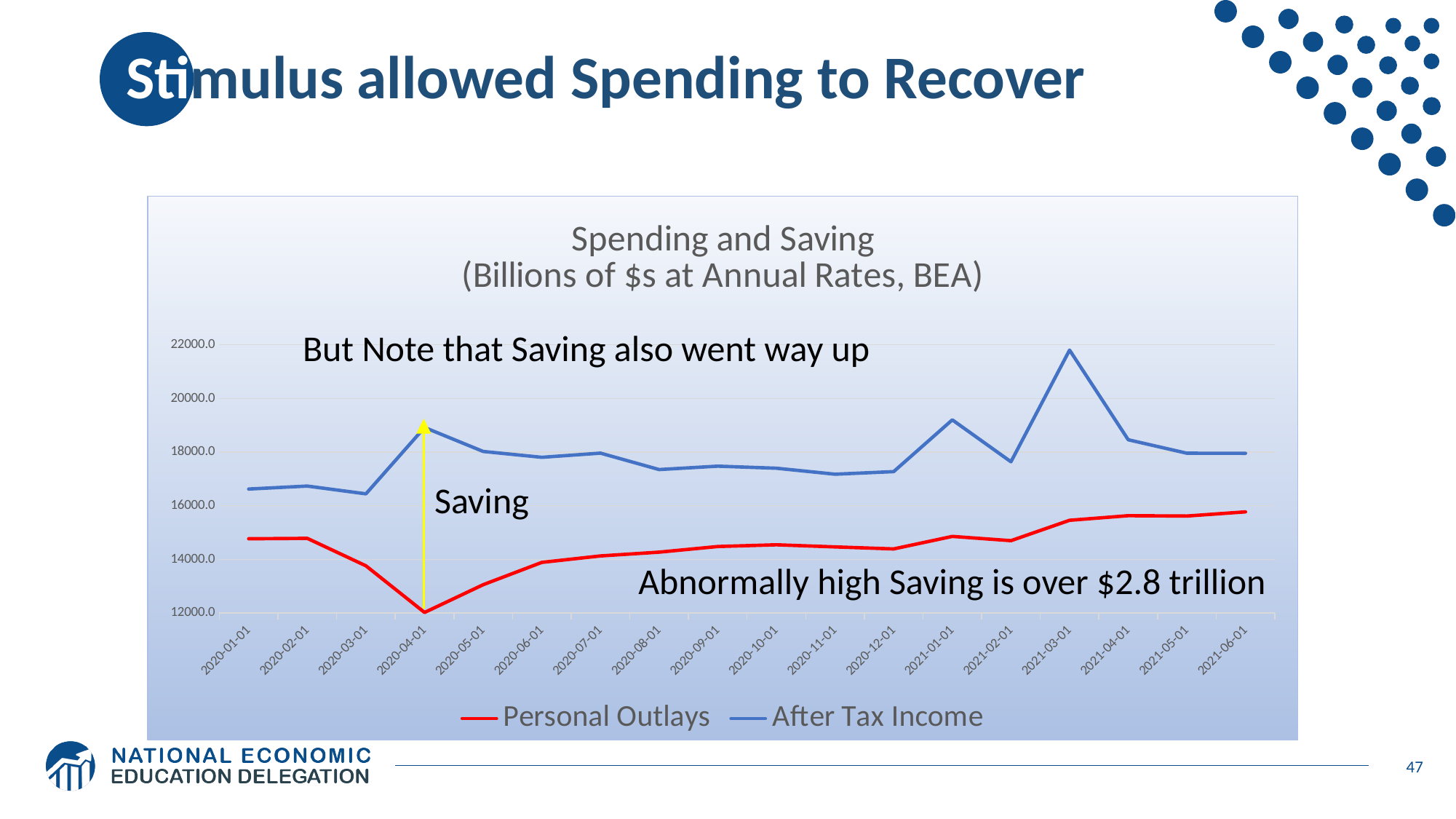
How many dates are plotted along the x axis? 18 What is the title of the chart? Spending and Saving (Billions of $s at Annual Rates, BEA) On which date does After Tax Income reach its highest value? 2021-03-01 Is the value for Personal Outlays at 2020-01-01 greater or less than 14000? greater What kind of chart is shown on the slide? line chart What colour is the Personal Outlays line? red How many series does the legend list? 2 Is the value for After Tax Income at 2020-01-01 greater or less than 16000? greater Do Personal Outlays rise or fall from 2020-04-01 to 2021-06-01? rise At 2020-04-01, which series has the higher value, Personal Outlays or After Tax Income? After Tax Income Is the value for After Tax Income at 2021-03-01 greater or less than 20000? greater On which date do Personal Outlays reach their lowest value? 2020-04-01